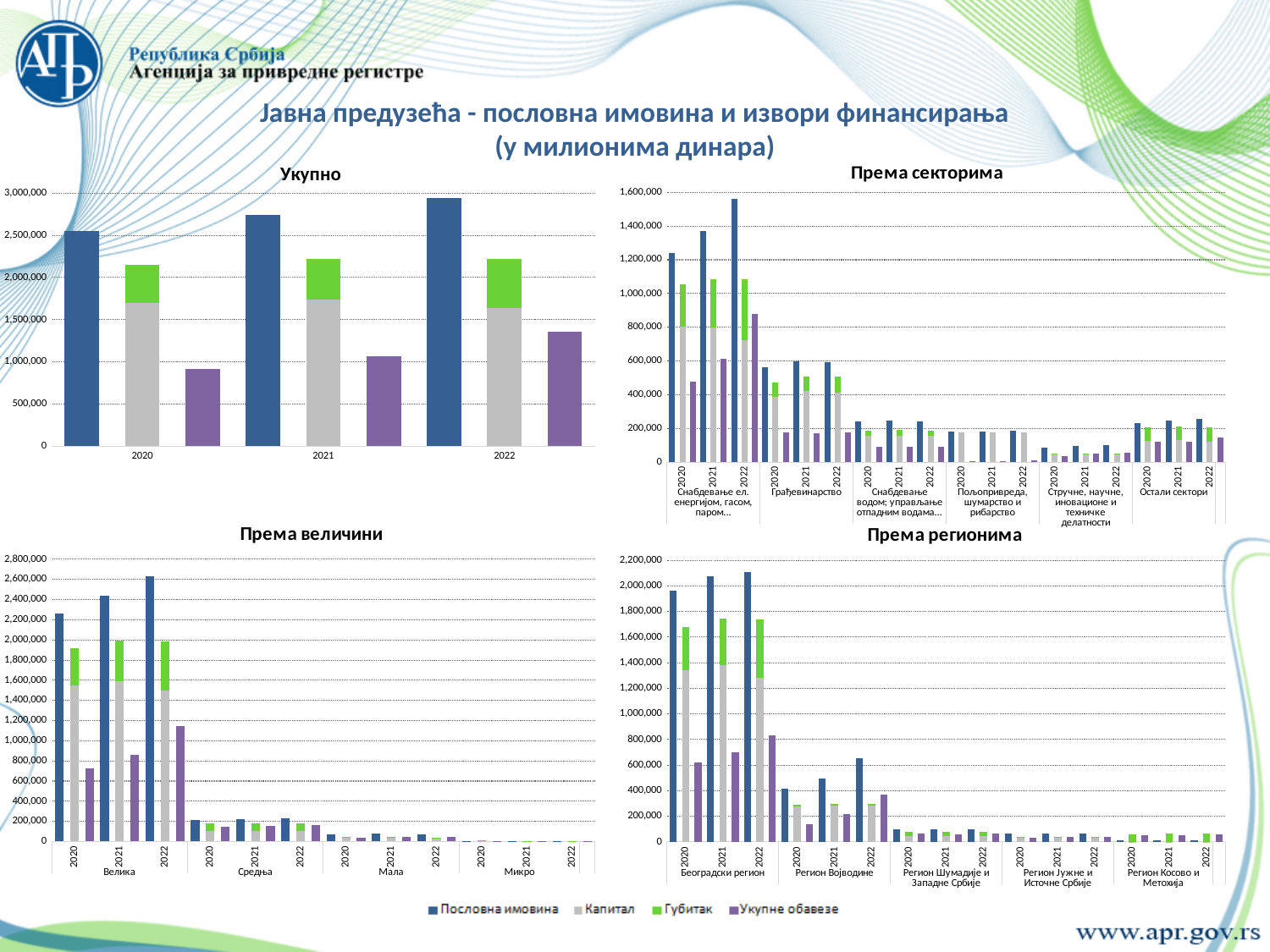
In the "Према величини" chart, is the value of Пословна имовина for Велика in 2022 greater or less than 2,400,000? greater What kind of chart is the "Укупно" chart? bar chart In the "Укупно" chart, does the value of Пословна имовина rise or fall from 2020 to 2022? rise In the "Укупно" chart, which year has the highest value of Укупне обавезе? 2022 How many regions are shown on the x axis of the "Према регионима" chart? 5 In the "Према секторима" chart, which sector has the highest Пословна имовина in 2022? Снабдевање ел. енергијом, гасом, паром... How many series does the legend at the bottom of the slide list? 4 In the "Према регионима" chart, is the value of Пословна имовина for Београдски регион in 2020 greater or less than 2,000,000? less How many size categories are shown on the x axis of the "Према величини" chart? 4 In the "Укупно" chart, is the value of Укупне обавезе for 2020 greater or less than 1,000,000? less In the "Према величини" chart, which size category has the highest Пословна имовина? Велика